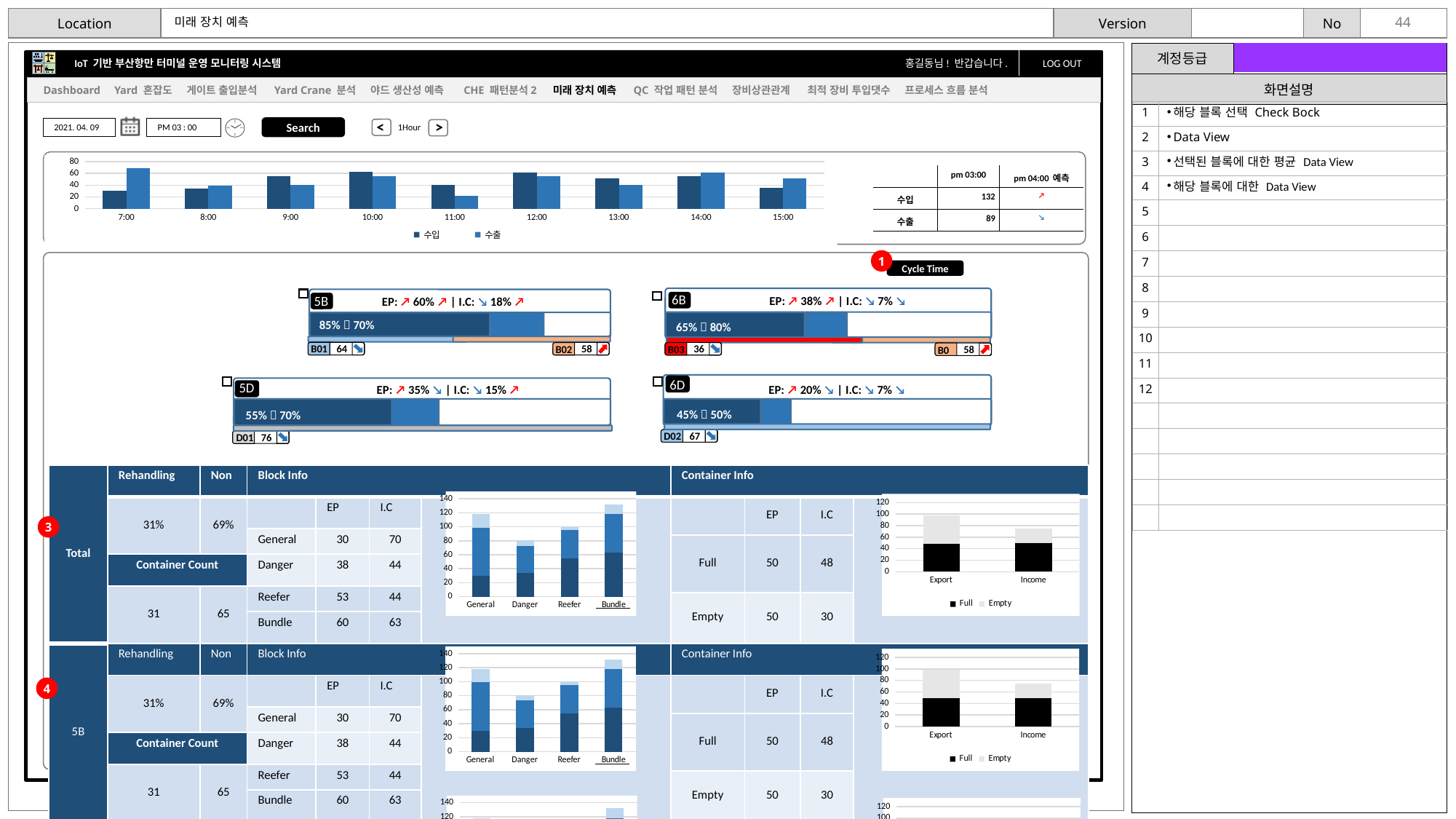
In the top hourly chart, at which hour is the 수출 bar highest? 7:00 What kind of chart is the hourly chart at the top of the dashboard (7:00 to 15:00)? bar chart In the top hourly chart, is the 수출 value at 11:00 greater or less than 40? less How many hour categories are shown on the x axis of the top hourly chart? 9 How many series does the legend of the top hourly chart list? 2 In the Container Info chart in the Total row, which series does the legend list? Full, Empty In the Block Info chart in the Total row, which category has the shortest stacked bar? Danger In the top hourly chart, which is larger at 11:00, 수입 or 수출? 수입 In the top hourly chart, is the 수출 value at 7:00 greater or less than 60? greater In the top hourly chart, which is larger at 7:00, 수입 or 수출? 수출 In the Block Info chart in the Total row, which category has the tallest stacked bar? Bundle In the Block Info chart in the Total row, how many categories are on the x axis? 4